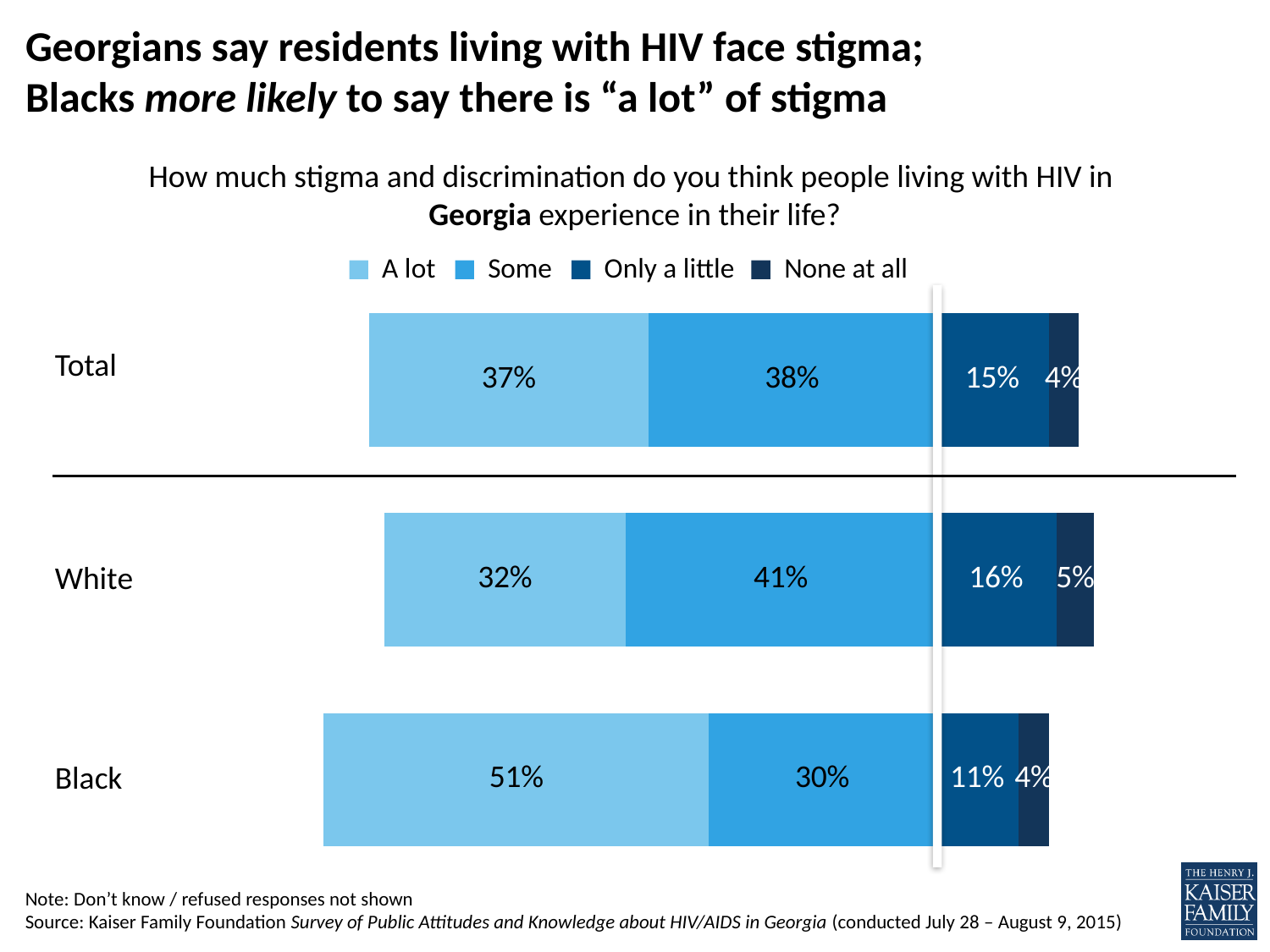
What percentage of Black respondents say people living with HIV in Georgia experience "a lot" of stigma? 51% Which group has the lowest share answering "Some"? Black How many response categories does the legend list? 4 Which is larger: the "Only a little" value for White or for Black respondents? White What percentage of White respondents answered "Some"? 41% Which group has the highest share answering "A lot"? Black What is the difference between the "A lot" percentages for Black and White respondents? 19 percentage points What is the total of the four labeled segments in the Total bar? 94% What type of chart is shown on the slide? Stacked bar chart What is the "Only a little" value for the Total group? 15% How many groups (bars) are shown in the chart? 3 What is the "None at all" value for White respondents? 5%